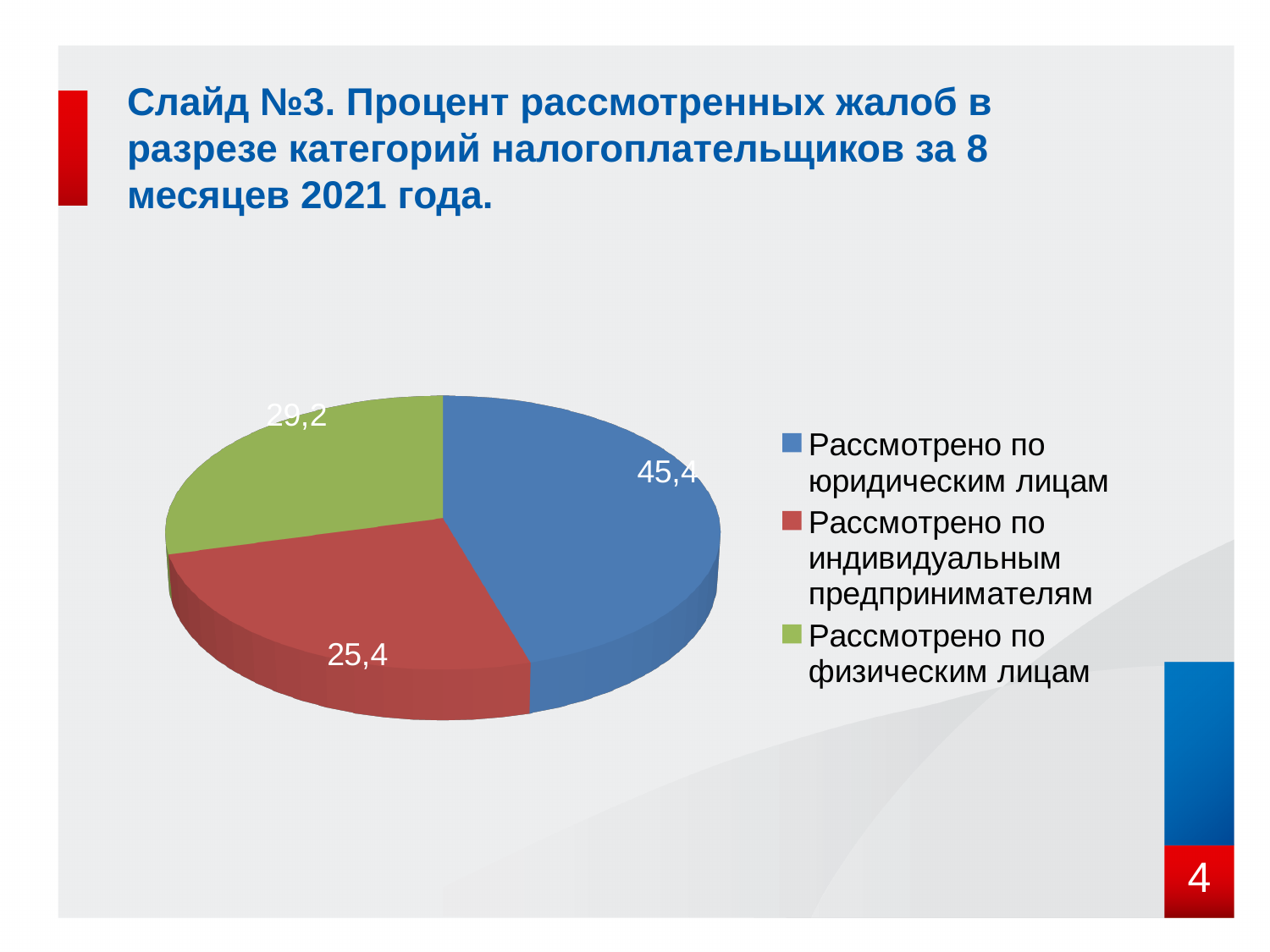
What is the value for "Рассмотрено по юридическим лицам"? 45,4 What kind of chart is shown on the slide? pie chart What is the difference between the values for "Рассмотрено по юридическим лицам" and "Рассмотрено по физическим лицам"? 16,2 Which category has the largest slice of the pie? Рассмотрено по юридическим лицам What is the value for "Рассмотрено по физическим лицам"? 29,2 What is the value for "Рассмотрено по индивидуальным предпринимателям"? 25,4 What colour is the slice for "Рассмотрено по юридическим лицам"? blue What colour is the slice for "Рассмотрено по физическим лицам"? green How many slices does the pie chart have? 3 Which is larger: the value for "Рассмотрено по физическим лицам" or for "Рассмотрено по индивидуальным предпринимателям"? Рассмотрено по физическим лицам Which category has the smallest slice of the pie? Рассмотрено по индивидуальным предпринимателям What is the difference between the values for "Рассмотрено по физическим лицам" and "Рассмотрено по индивидуальным предпринимателям"? 3,8